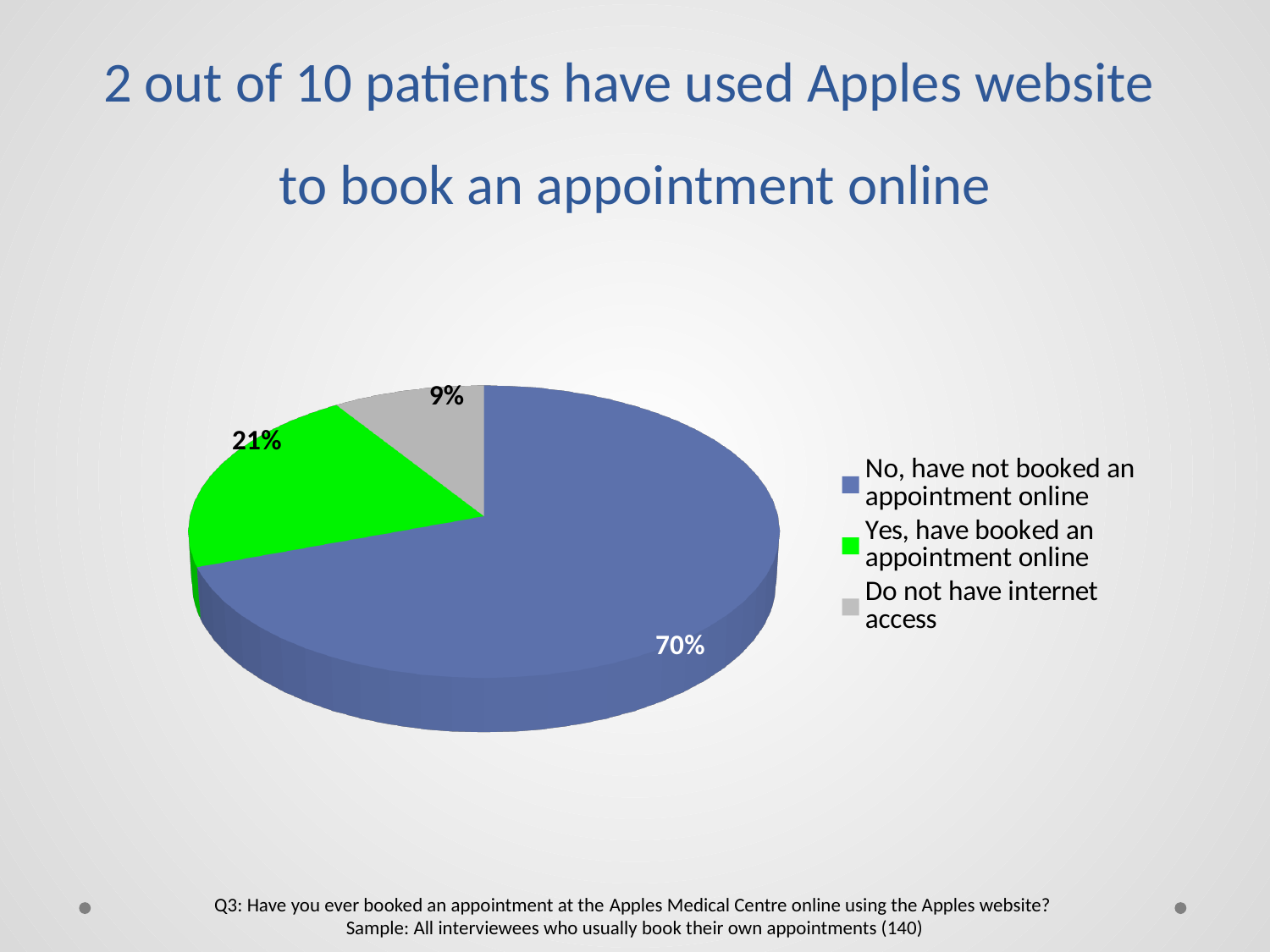
Which category has the largest share of the pie? No, have not booked an appointment online What is the difference in percentage points between those who have not booked online and those who have booked online? 49 What percentage of patients have booked an appointment online? 21% How many categories are shown in the pie chart? 3 Which is larger: the share who have booked an appointment online or the share who do not have internet access? Yes, have booked an appointment online Which category has the smallest share of the pie? Do not have internet access What type of chart is shown on the slide? Pie chart What percentage of patients have not booked an appointment online? 70% What is the sample size stated at the bottom of the slide? 140 What colour is the slice for 'Yes, have booked an appointment online'? Green What percentage of patients do not have internet access? 9%